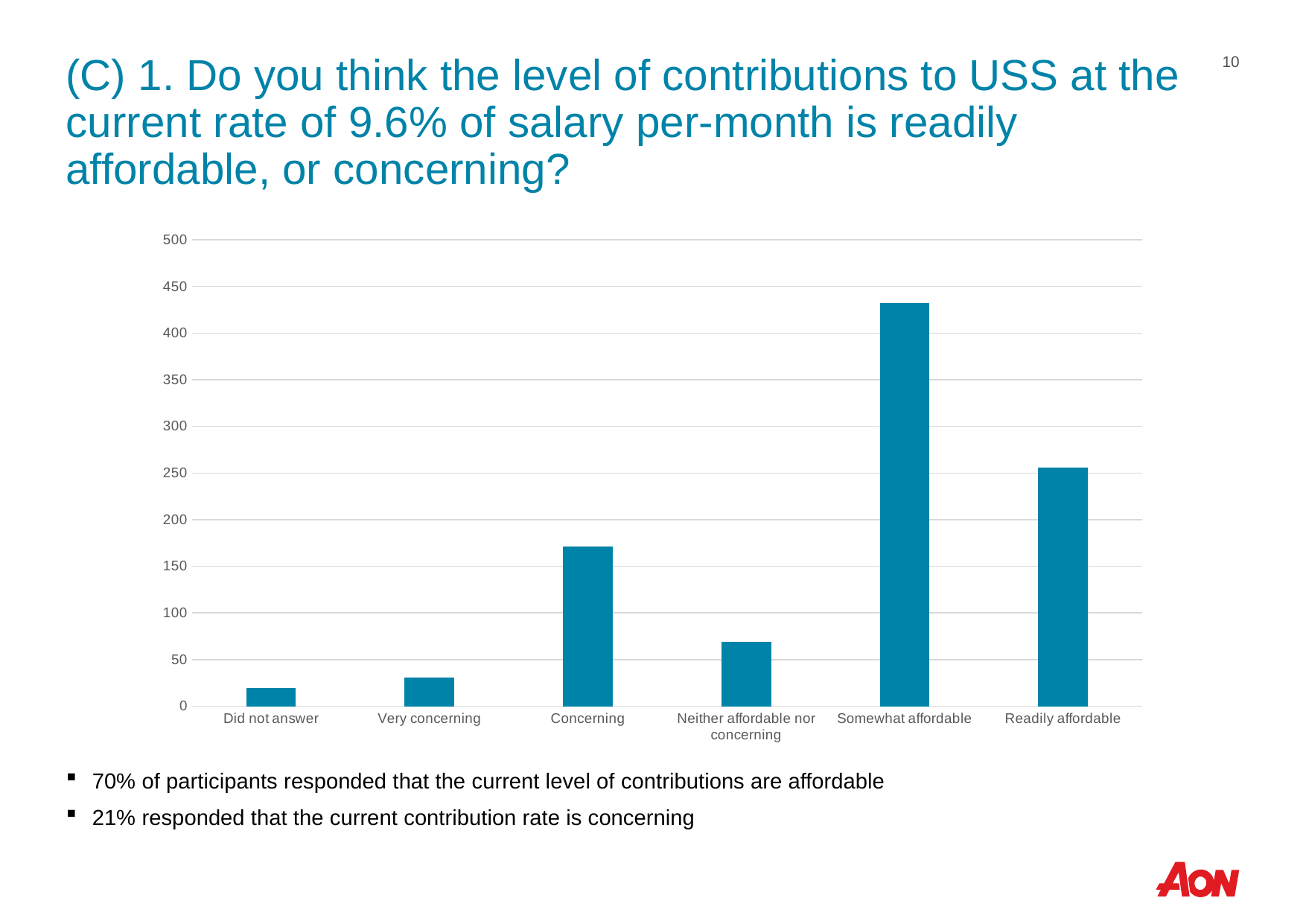
Is the value for Somewhat affordable greater or less than 400? greater Is the value for Did not answer greater or less than 50? less According to the bullet text below the chart, what percentage of participants responded that the current contribution rate is concerning? 21% How many categories are shown on the x axis of the chart? 6 Which is larger, the value for Readily affordable or the value for Somewhat affordable? Somewhat affordable Is the value for Concerning greater or less than 150? greater What is the highest value shown on the y axis of the chart? 500 Which category has the highest value in the chart? Somewhat affordable What kind of chart is shown on the slide? bar chart Which is larger, the value for Concerning or the value for Neither affordable nor concerning? Concerning